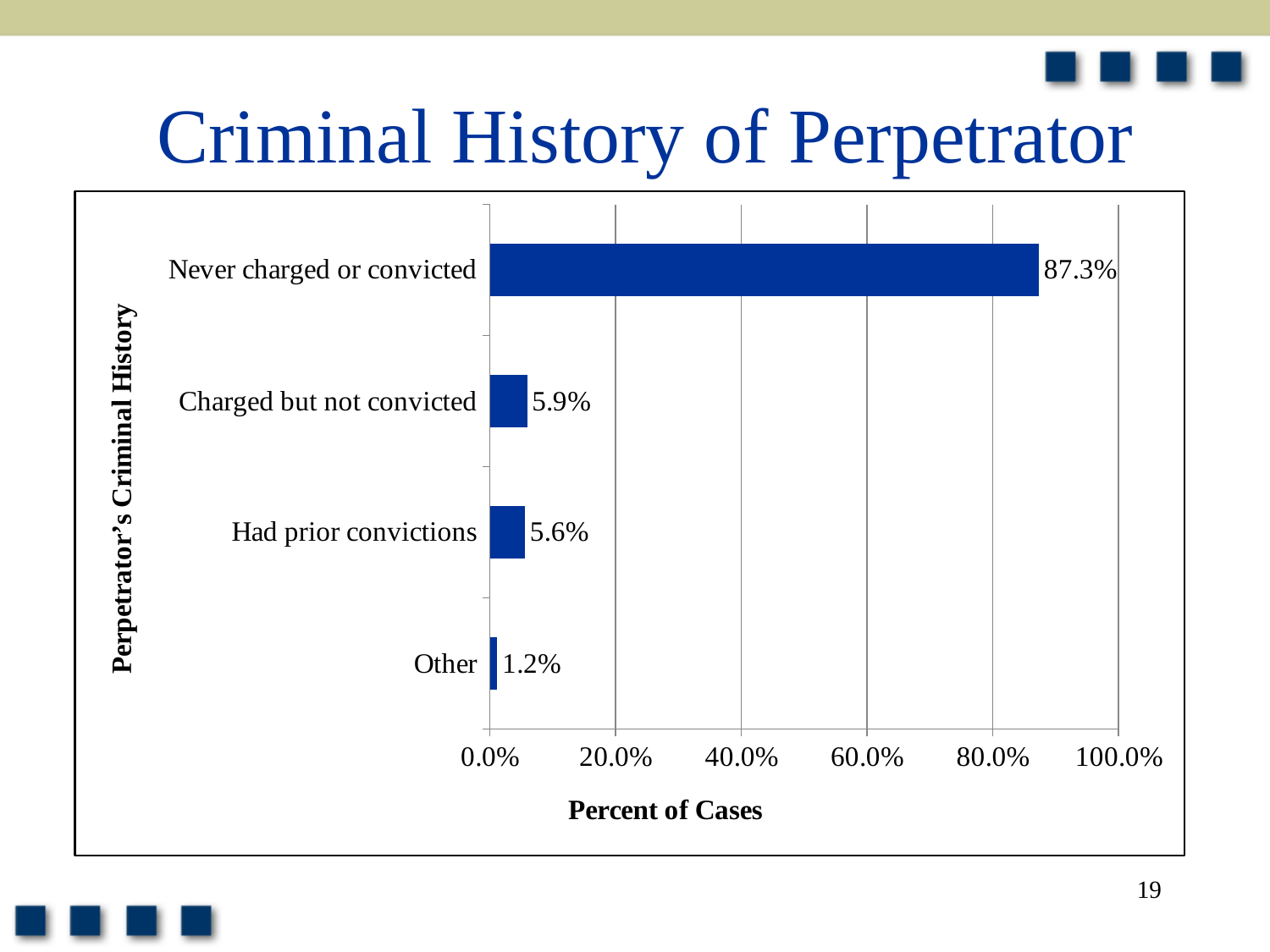
Which criminal history category has the lowest percent of cases? Other What percent of cases had a perpetrator who was charged but not convicted? 5.9% What percent of cases fall into the 'Other' criminal history category? 1.2% Which has a larger percent of cases: 'Charged but not convicted' or 'Other'? Charged but not convicted What percent of cases had a perpetrator with prior convictions? 5.6% What type of chart is shown on the slide? Bar chart Which criminal history category has the highest percent of cases? Never charged or convicted How many criminal history categories are shown in the chart? 4 Is the value for 'Never charged or convicted' greater or less than 80.0%? greater What percent of cases had a perpetrator who was never charged or convicted? 87.3% What is the difference in percent of cases between 'Never charged or convicted' and 'Charged but not convicted'? 81.4% What is the difference in percent of cases between 'Had prior convictions' and 'Other'? 4.4%